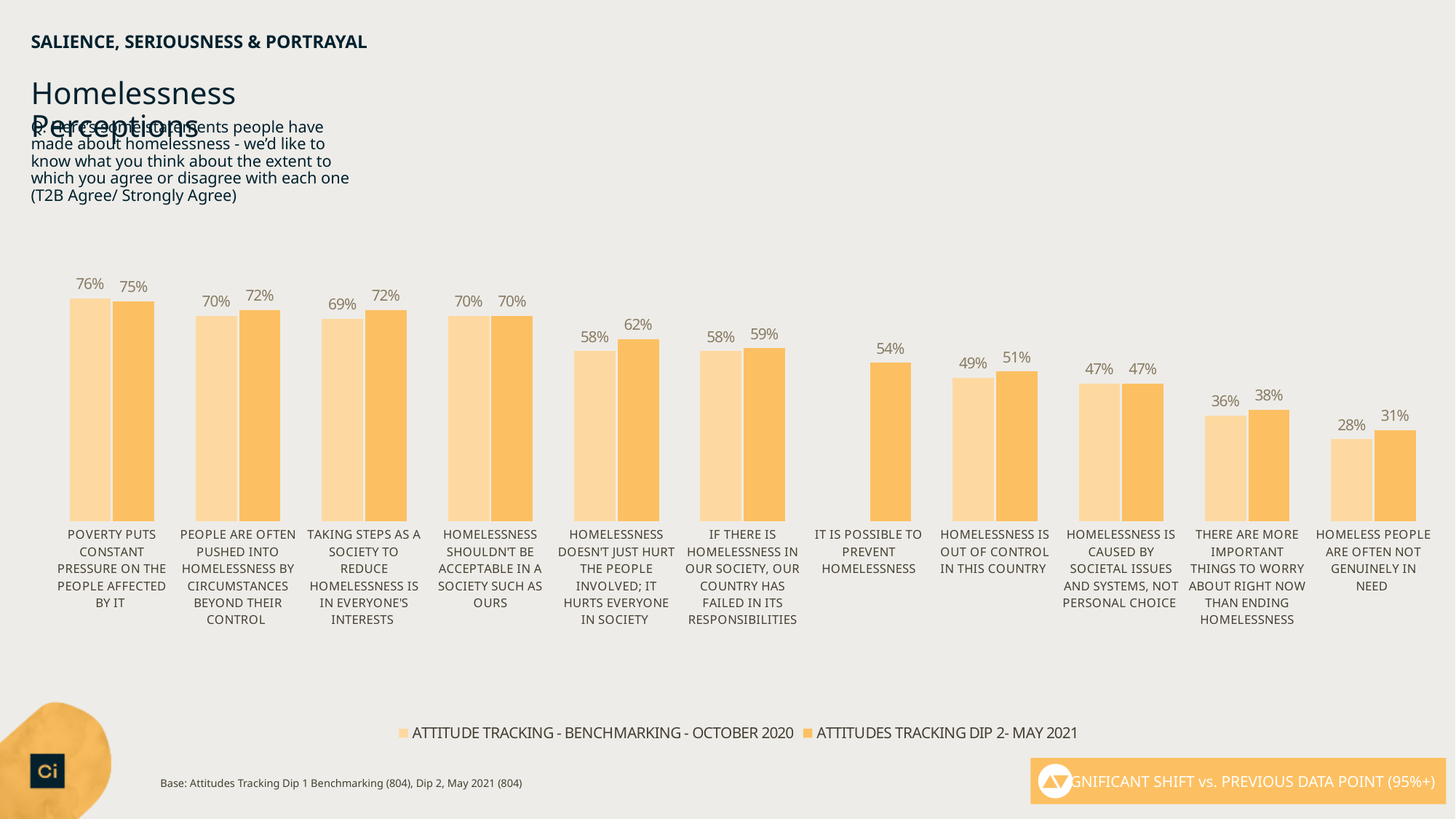
How many series does the legend list? 2 Do the values generally rise or fall moving from left to right along the x axis? Fall What is the difference between the May 2021 and October 2020 values for 'Homelessness doesn't just hurt the people involved; it hurts everyone in society'? 4% How many statements (categories) are shown on the x axis? 11 Which is larger for 'Taking steps as a society to reduce homelessness is in everyone's interests': the October 2020 value or the May 2021 value? May 2021 Which statement has the lowest value in the October 2020 series? Homeless people are often not genuinely in need What is the value for 'Poverty puts constant pressure on the people affected by it' in the Attitude Tracking - Benchmarking - October 2020 series? 76% Which statement has only one bar (no October 2020 value)? It is possible to prevent homelessness What is the May 2021 value for 'It is possible to prevent homelessness'? 54% Which statement has the highest value in the May 2021 series? Poverty puts constant pressure on the people affected by it What kind of chart is shown on the slide? Bar chart What is the value for 'Homeless people are often not genuinely in need' in the Attitudes Tracking Dip 2 - May 2021 series? 31%